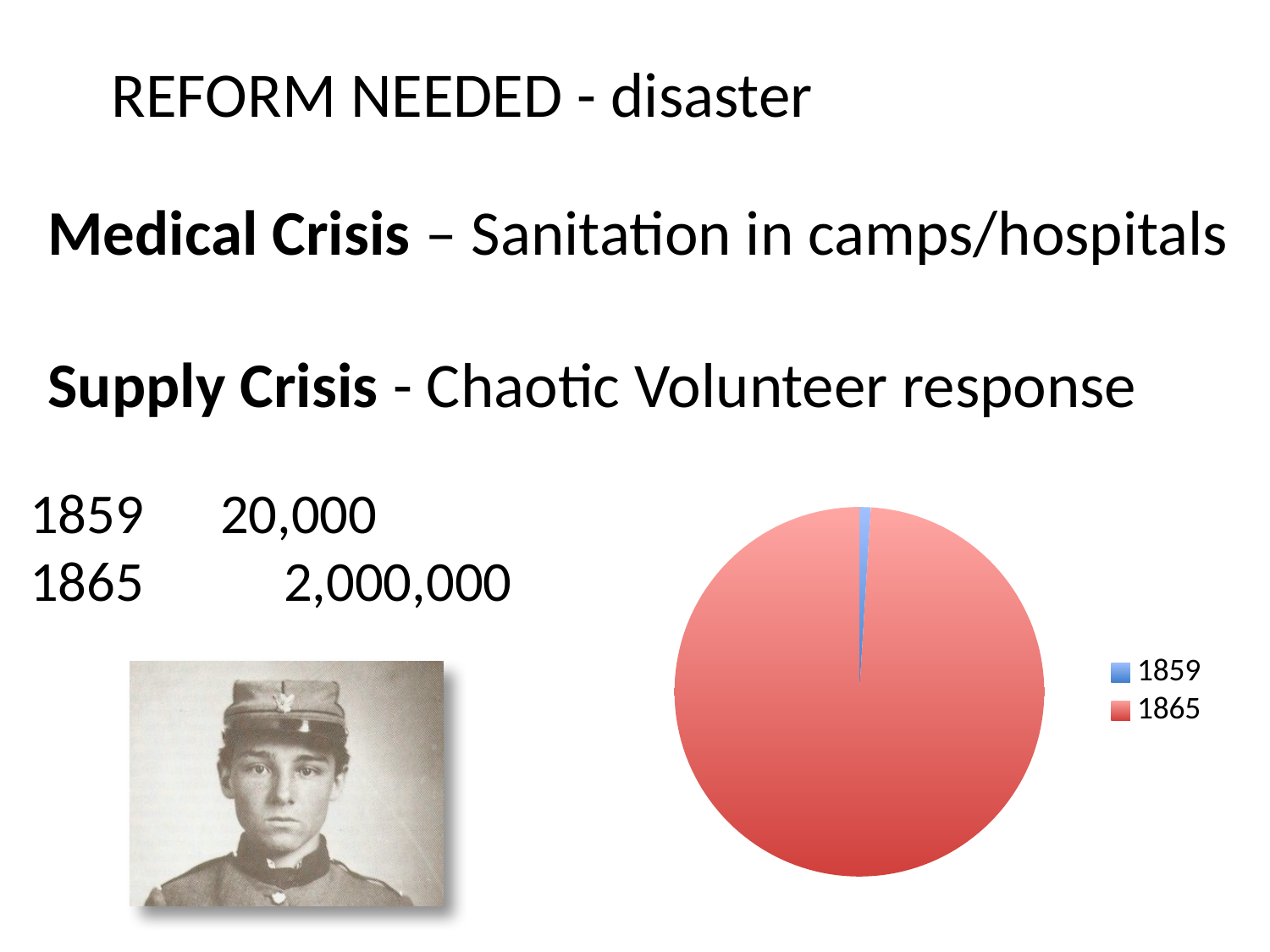
According to the figures on the slide, what is the value for 1859? 20,000 How many slices does the pie chart have? 2 Which is larger in the pie chart, the slice for 1859 or the slice for 1865? 1865 What colour is the slice for 1865 in the pie chart? red Which category takes up the smallest share of the pie chart? 1859 What colour is the slice for 1859 in the pie chart? blue Which category takes up the largest share of the pie chart? 1865 Using the figures on the slide, how much larger is the value for 1865 than the value for 1859? 1,980,000 How many entries does the pie chart's legend list? 2 According to the figures on the slide, what is the value for 1865? 2,000,000 What kind of chart is shown on the slide? pie chart